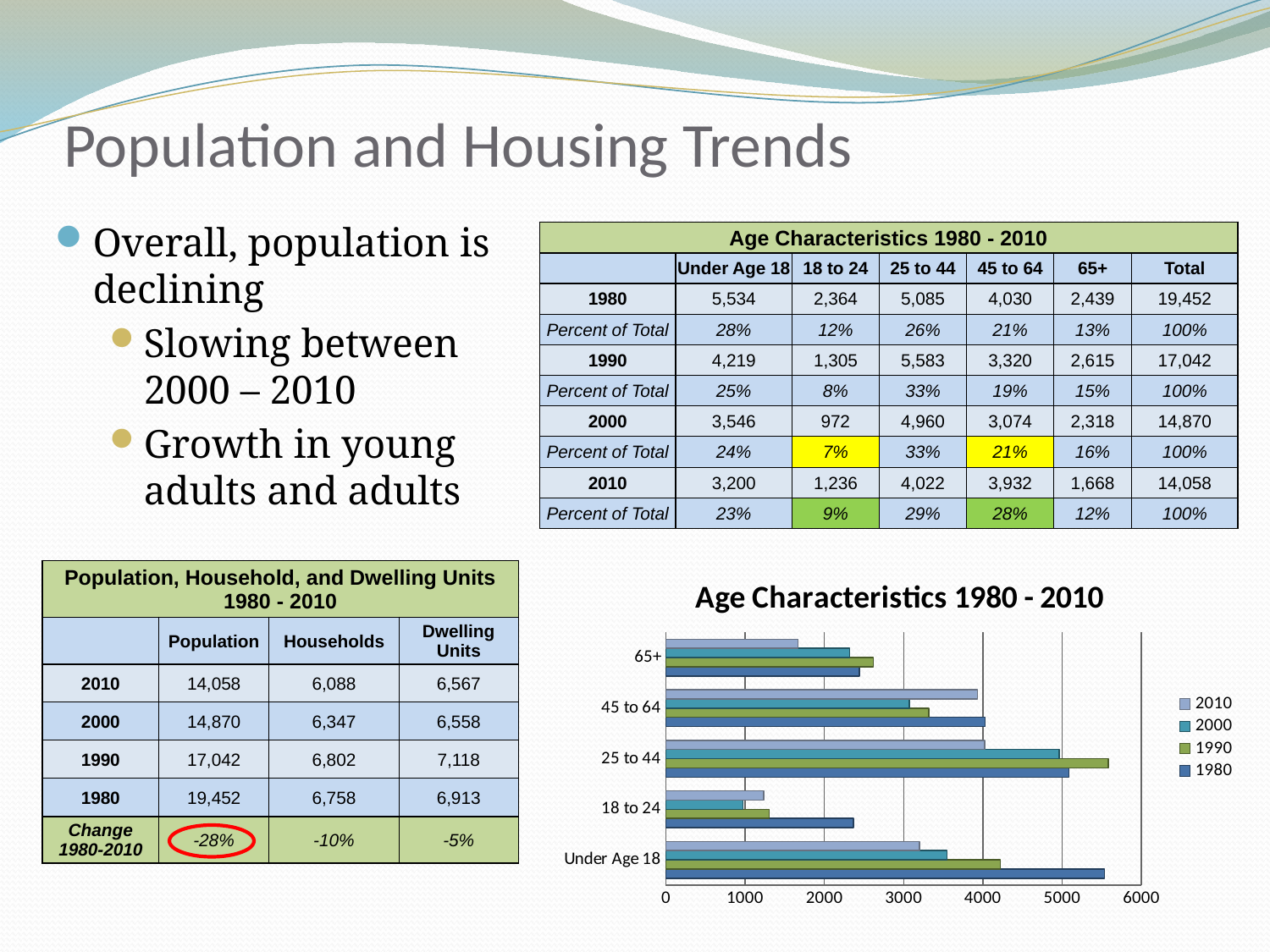
In the Age Characteristics 1980 - 2010 chart, for the 45 to 64 category, which is larger: the 2010 value or the 2000 value? 2010 How many age categories are shown on the Age Characteristics 1980 - 2010 chart? 5 In the Age Characteristics 1980 - 2010 chart, is the 1990 value for 65+ greater or less than 2000? greater In the Age Characteristics 1980 - 2010 chart, which age category has the highest value for the 1990 series? 25 to 44 In the Age Characteristics 1980 - 2010 chart, is the 1980 value for Under Age 18 greater or less than 5000? greater In the Age Characteristics 1980 - 2010 chart, which age category has the highest value for the 1980 series? Under Age 18 In the Age Characteristics 1980 - 2010 chart, is the 2010 value for 18 to 24 greater or less than 2000? less What kind of chart is the Age Characteristics 1980 - 2010 chart? bar chart How many series does the legend of the Age Characteristics 1980 - 2010 chart list? 4 What is the highest tick value shown on the x axis of the Age Characteristics 1980 - 2010 chart? 6000 In the Age Characteristics 1980 - 2010 chart, for the 25 to 44 category, which is larger: the 1990 value or the 2010 value? 1990 In the Age Characteristics 1980 - 2010 chart, which age category has the lowest value for the 2000 series? 18 to 24